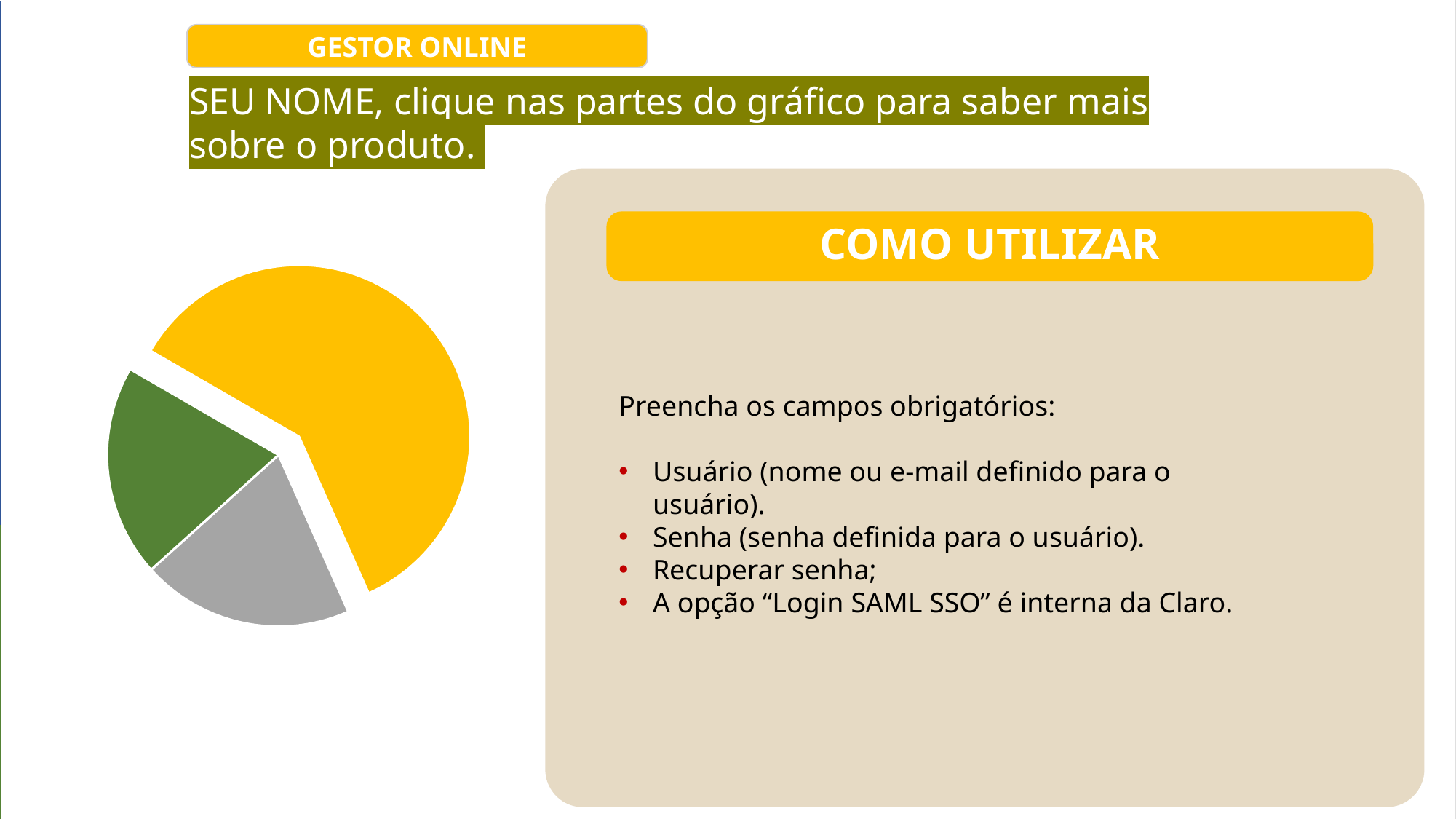
What kind of chart is shown on the left of the slide? pie chart Does the yellow slice take up more or less than half of the pie chart? more Does the pie chart display a legend? No Which colour slice is the largest in the pie chart? yellow How many slices does the pie chart have? 3